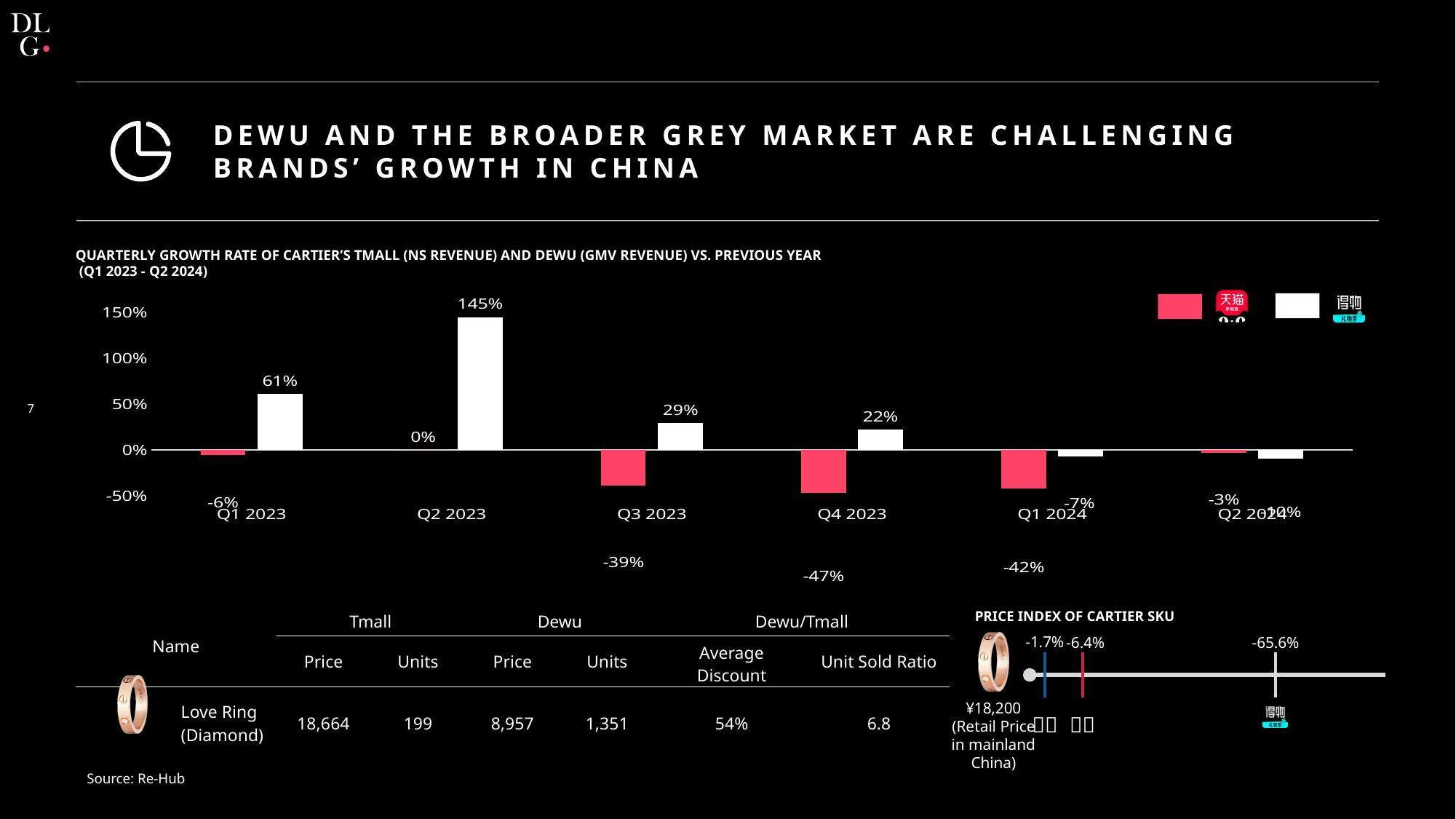
In the quarterly growth rate chart, what is the Tmall growth rate for Q4 2023? -47% In the quarterly growth rate chart, which is larger for Q3 2023: the Tmall growth rate or the Dewu growth rate? Dewu In the quarterly growth rate chart, what is the Tmall growth rate for Q1 2023? -6% In the quarterly growth rate chart, what is the Dewu growth rate for Q4 2023? 22% How many quarters are shown on the x axis of the quarterly growth rate chart? 6 In the quarterly growth rate chart, which quarter has the lowest Tmall growth rate? Q4 2023 In the quarterly growth rate chart, does the Dewu growth rate rise or fall from Q2 2023 to Q1 2024? Fall In the quarterly growth rate chart, what is the difference between the Dewu growth rates for Q2 2023 and Q1 2023? 84 percentage points How many series does the quarterly growth rate chart plot? 2 In the quarterly growth rate chart, which quarter has the highest Dewu growth rate? Q2 2023 In the quarterly growth rate chart, what is the Dewu growth rate for Q2 2023? 145% What kind of chart is used to show the quarterly growth rate of Cartier's Tmall and Dewu revenue? Bar chart